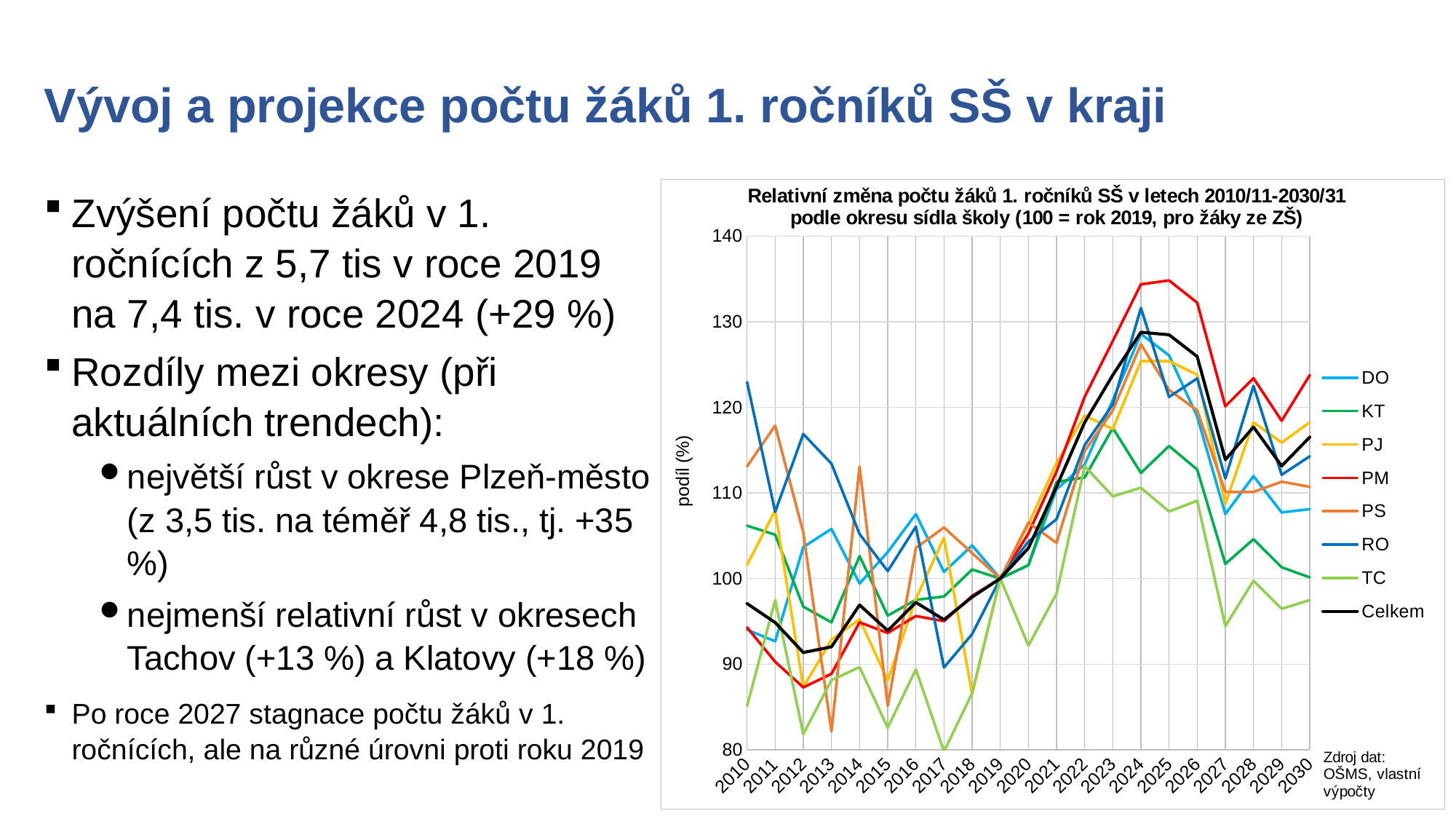
What is the label of the y axis of the chart? podíl (%) Which series has the highest value in 2025? PM Which series has the lowest value in 2025? TC Does the Celkem series rise or fall between 2019 and 2024? rise Is the value for TC in 2017 greater or less than 90? less How many series does the chart legend list? 8 Is the value for Celkem in 2024 greater or less than 120? greater How many years are shown on the x axis of the chart? 21 Which is larger in 2024, the value for PM or the value for TC? PM What kind of chart is shown on the slide? line chart Which series has the lowest value in 2030? TC Is the value for PM in 2025 greater or less than 130? greater